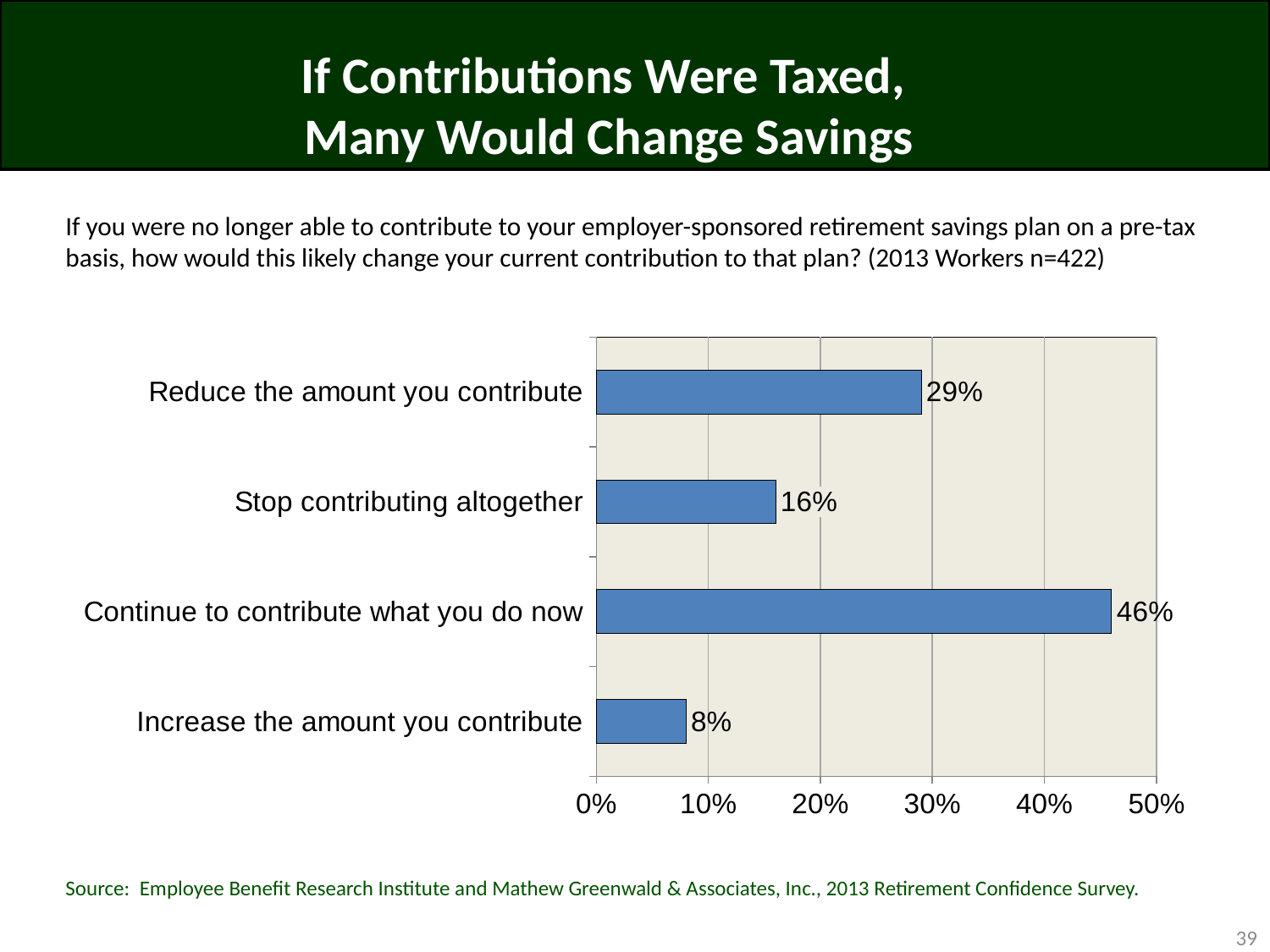
What kind of chart is shown on the slide? Bar chart What is the value for "Increase the amount you contribute"? 8% How many response categories are shown in the chart? 4 Which response has the lowest percentage? Increase the amount you contribute Which response has the highest percentage? Continue to contribute what you do now Is the value for "Continue to contribute what you do now" greater or less than 40%? greater What percentage said they would continue to contribute what they do now? 46% What is the value for "Stop contributing altogether"? 16% What is the difference between "Stop contributing altogether" and "Increase the amount you contribute"? 8 percentage points What percentage of workers said they would reduce the amount they contribute? 29% What is the difference between "Continue to contribute what you do now" and "Reduce the amount you contribute"? 17 percentage points Which is larger, "Reduce the amount you contribute" or "Stop contributing altogether"? Reduce the amount you contribute